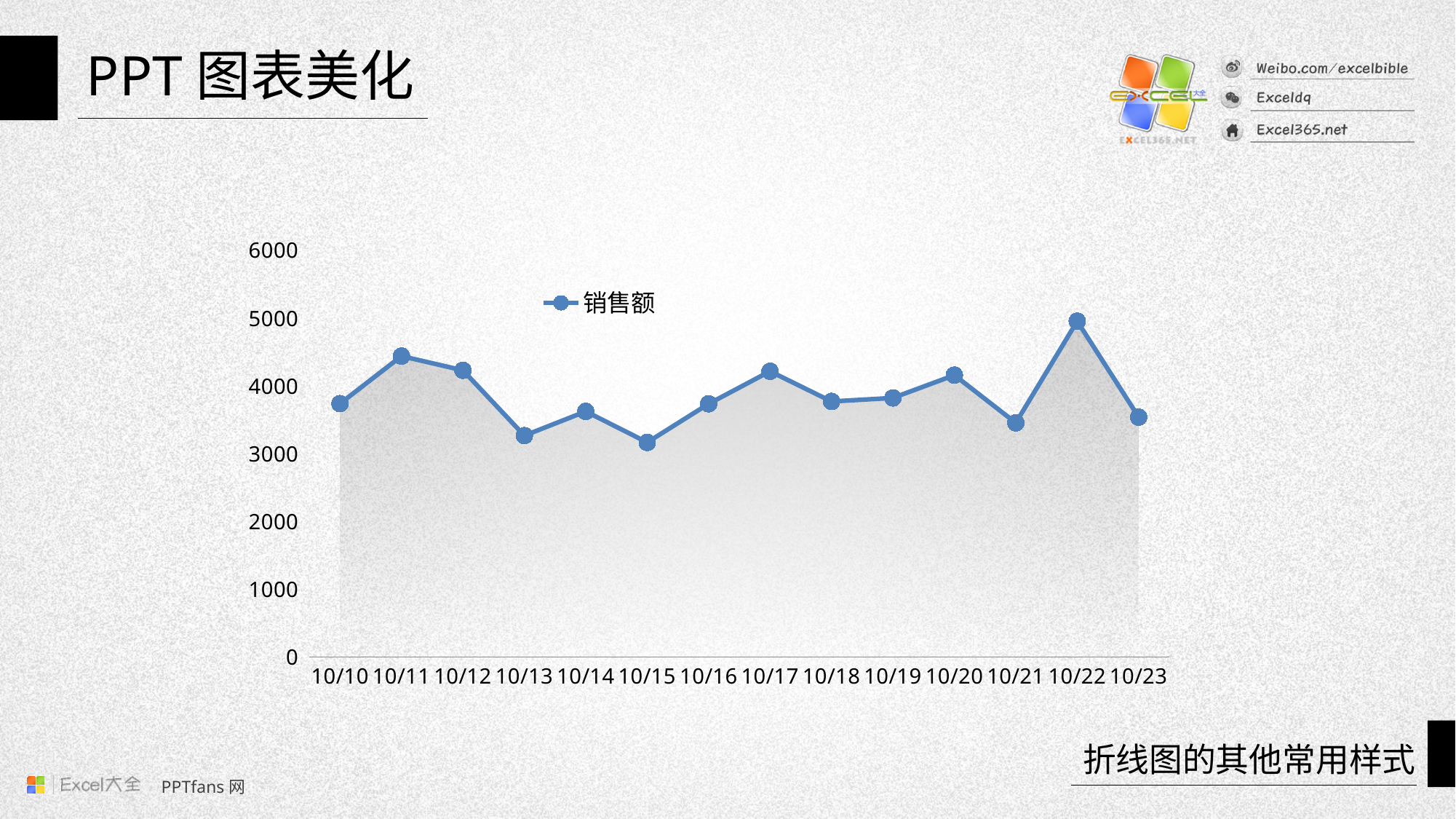
How many data points are plotted along the x axis? 14 Which date has the highest value for 销售额? 10/22 Which is larger, the value for 10/11 or the value for 10/13? 10/11 What is the name of the series shown in the legend? 销售额 Is the value for 10/15 greater or less than 4000? less How many series does the chart legend list? 1 Does the value rise or fall from 10/22 to 10/23? fall Is the value for 10/11 greater or less than 4000? greater Which is larger, the value for 10/22 or the value for 10/23? 10/22 Is the value for 10/13 greater or less than 3000? greater What kind of chart is shown on the slide? line chart